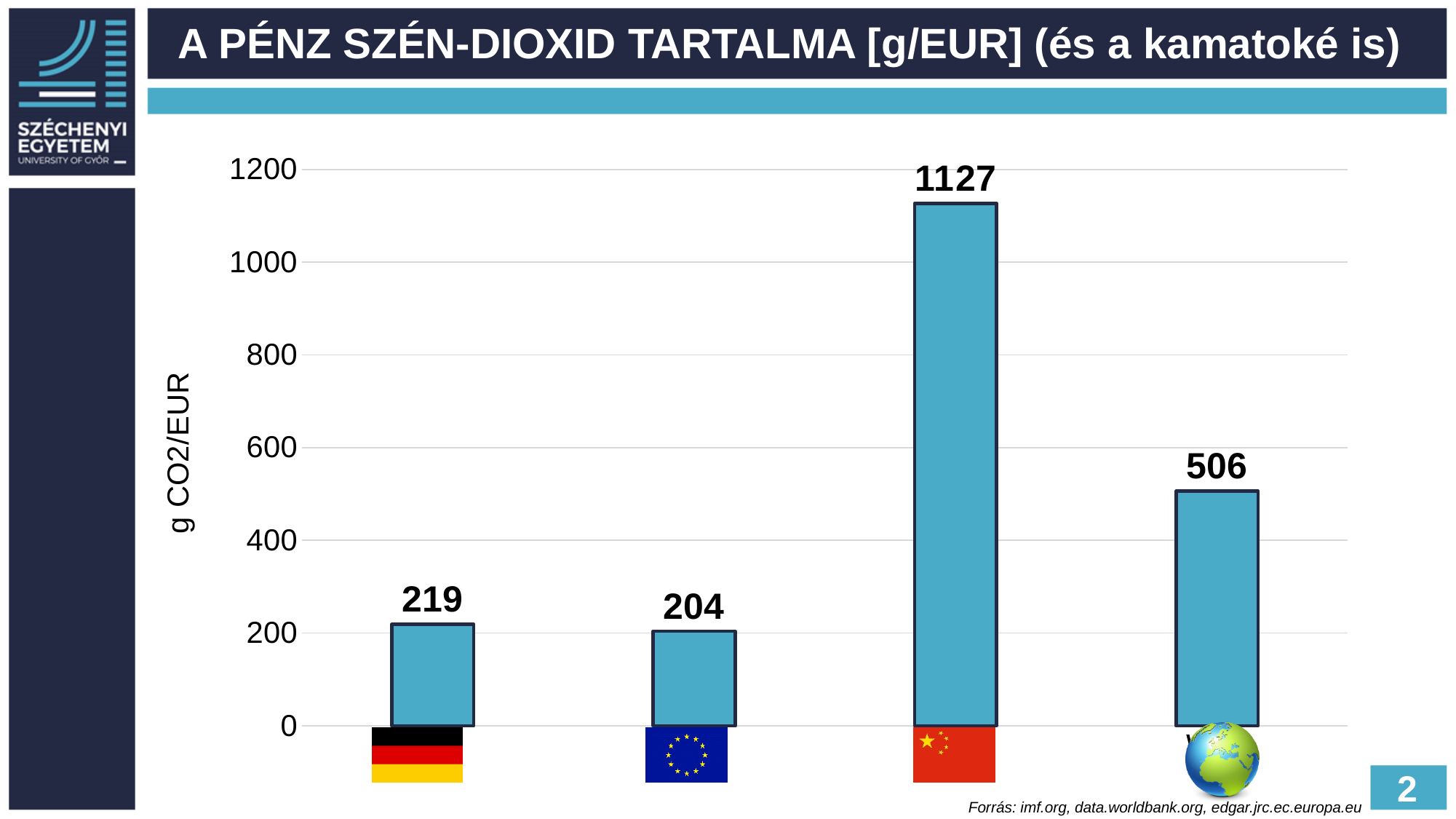
Which bar has the highest value? The bar with the Chinese flag What is the value of the bar marked with the globe icon? 506 What is the difference between the bar with the Chinese flag and the bar with the globe icon? 621 What is the difference between the bar with the German flag and the bar with the EU flag? 15 What is the value of the bar marked with the EU flag? 204 What is the label of the vertical axis? g CO2/EUR How many bars are shown in the chart? 4 What kind of chart is shown on the slide? Bar chart Which is larger, the bar with the globe icon or the bar with the German flag? The bar with the globe icon What is the value of the bar marked with the Chinese flag? 1127 Which bar has the lowest value? The bar with the EU flag What is the value of the bar marked with the German flag? 219